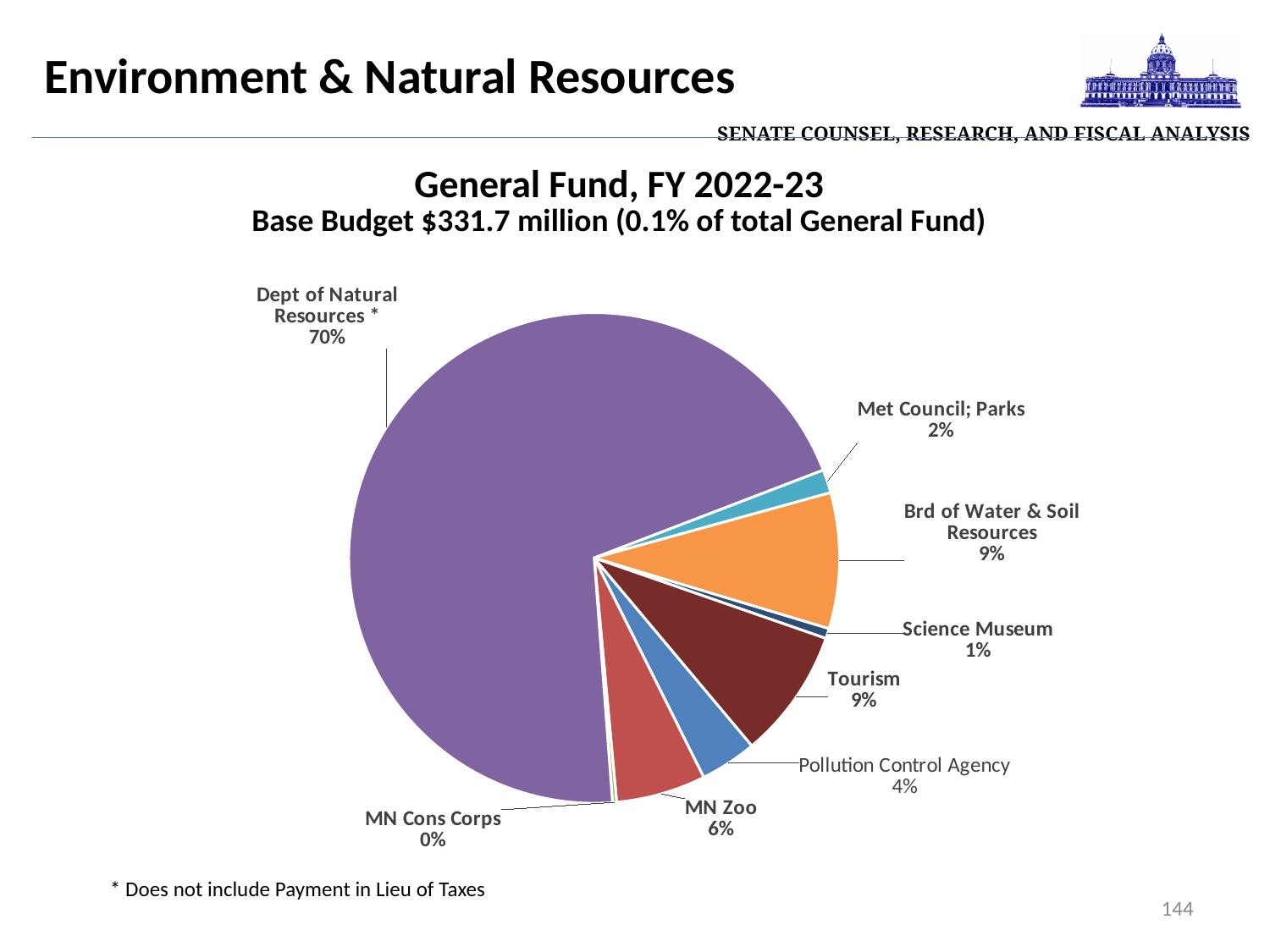
What share of the pie does MN Zoo have? 6% What share of the pie does Dept of Natural Resources * have? 70% Which category has the largest slice of the pie? Dept of Natural Resources * How many categories are shown in the pie chart? 8 What is the title of the chart? General Fund, FY 2022-23 Base Budget $331.7 million (0.1% of total General Fund) What share of the pie does Met Council; Parks have? 2% What kind of chart is shown on the slide? Pie chart Which is larger, the share for MN Zoo or the share for Pollution Control Agency? MN Zoo What is the difference in percentage points between Dept of Natural Resources * and Brd of Water & Soil Resources? 61 Which category has the smallest slice of the pie? MN Cons Corps